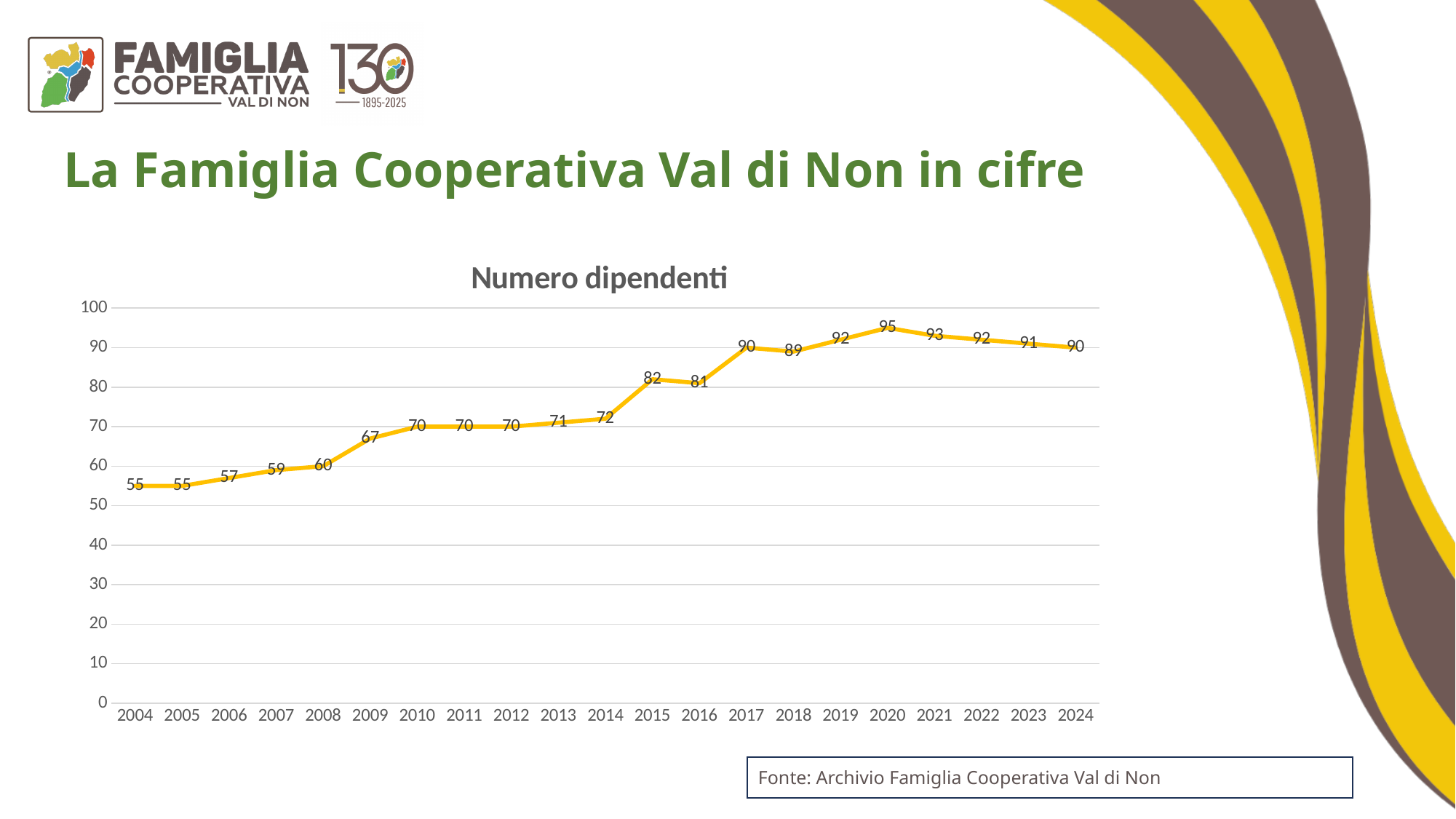
What is the difference between the values for 2020 and 2004? 40 Does the value rise or fall from 2004 to 2020? rise What is the title of the chart? Numero dipendenti What is the value for 2024? 90 What is the difference between the values for 2009 and 2008? 7 Which is larger, the value for 2016 or the value for 2017? 2017 How many years are plotted on the x axis? 21 What is the value for 2015? 82 What is the highest value shown on the chart? 95 What is the number of employees in 2004? 55 Which year has the highest value? 2020 What kind of chart is shown on the slide? line chart